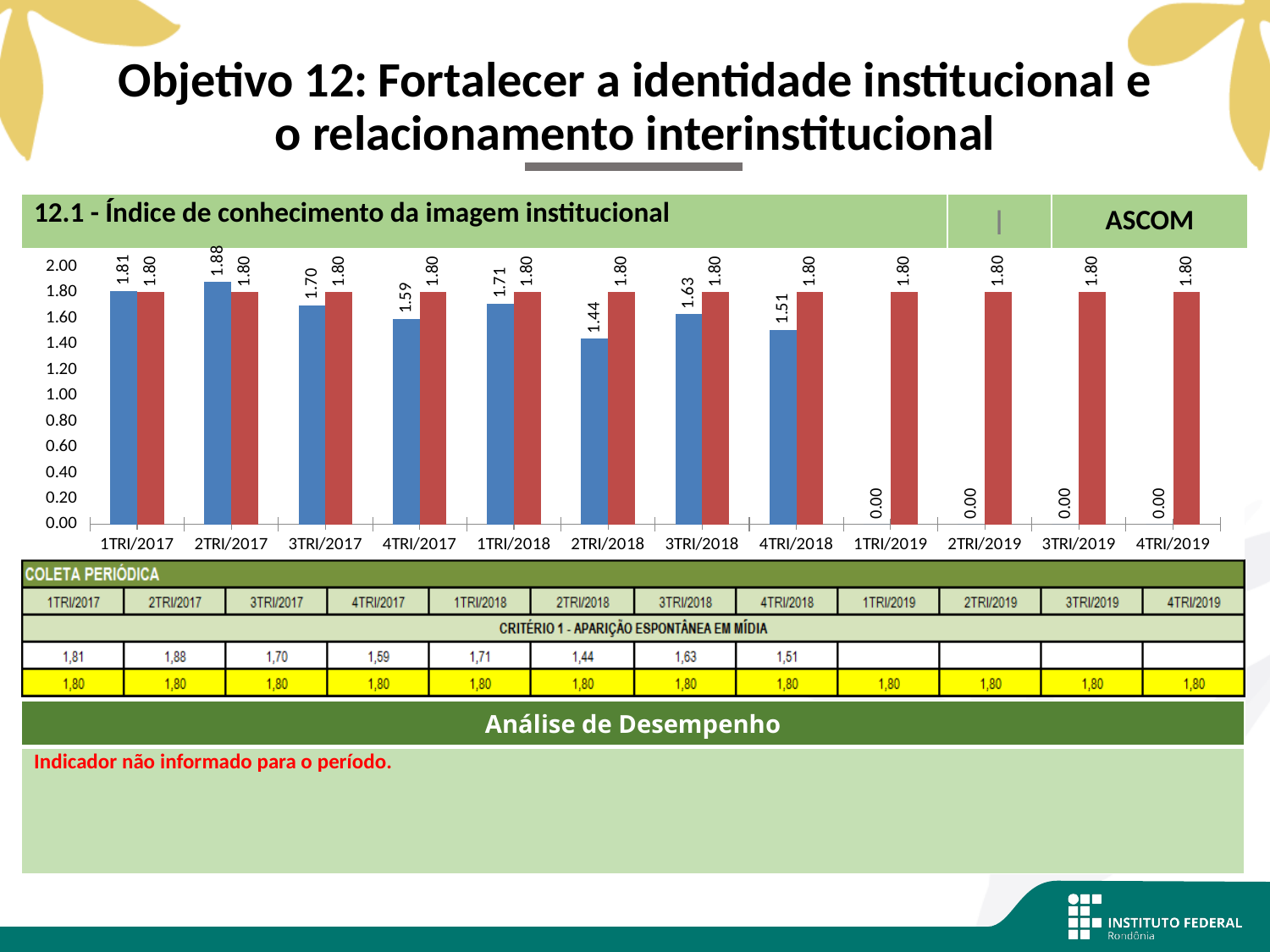
Which quarter has the highest blue bar value? 2TRI/2017 Which is larger, the blue bar for 4TRI/2017 or the blue bar for 1TRI/2018? 1TRI/2018 What is the value of the blue bar for 2TRI/2018? 1.44 What is the difference between the blue bar value for 2TRI/2017 and the red bar value for 2TRI/2017? 0.08 Among the quarters of 2017 and 2018, which has the lowest blue bar value? 2TRI/2018 How many quarters are shown on the x axis of the chart? 12 What is the value of the blue bar for 1TRI/2019? 0.00 What is the title of the chart? 12.1 - Índice de conhecimento da imagem institucional Is the blue bar value for 4TRI/2018 greater or less than 1.60? less What is the value of the red bar for 3TRI/2018? 1.80 What is the value of the blue bar for 2TRI/2017? 1.88 What kind of chart is shown on the slide? bar chart